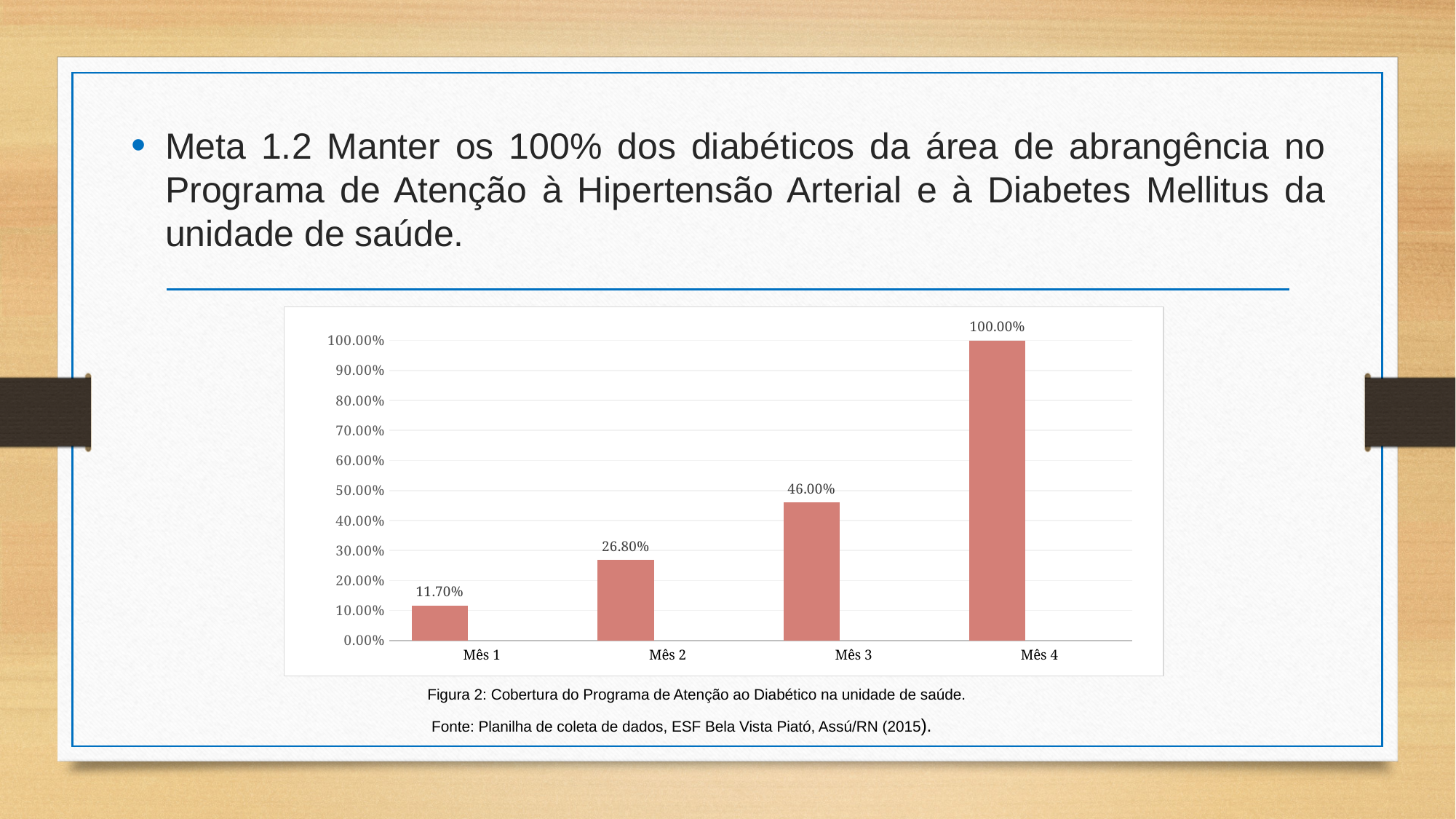
What is the value for Mês 1? 11.70% Which is larger, the value for Mês 2 or the value for Mês 3? Mês 3 How many months are shown on the x axis? 4 What is the difference between the values for Mês 4 and Mês 3? 54.00% What is the value for Mês 4? 100.00% What kind of chart is shown on the slide? Bar chart What is the value for Mês 3? 46.00% What is the value for Mês 2? 26.80% Which month has the lowest value? Mês 1 What is the difference between the values for Mês 2 and Mês 1? 15.10% Which month has the highest value? Mês 4 Do the values rise or fall from Mês 1 to Mês 4? Rise